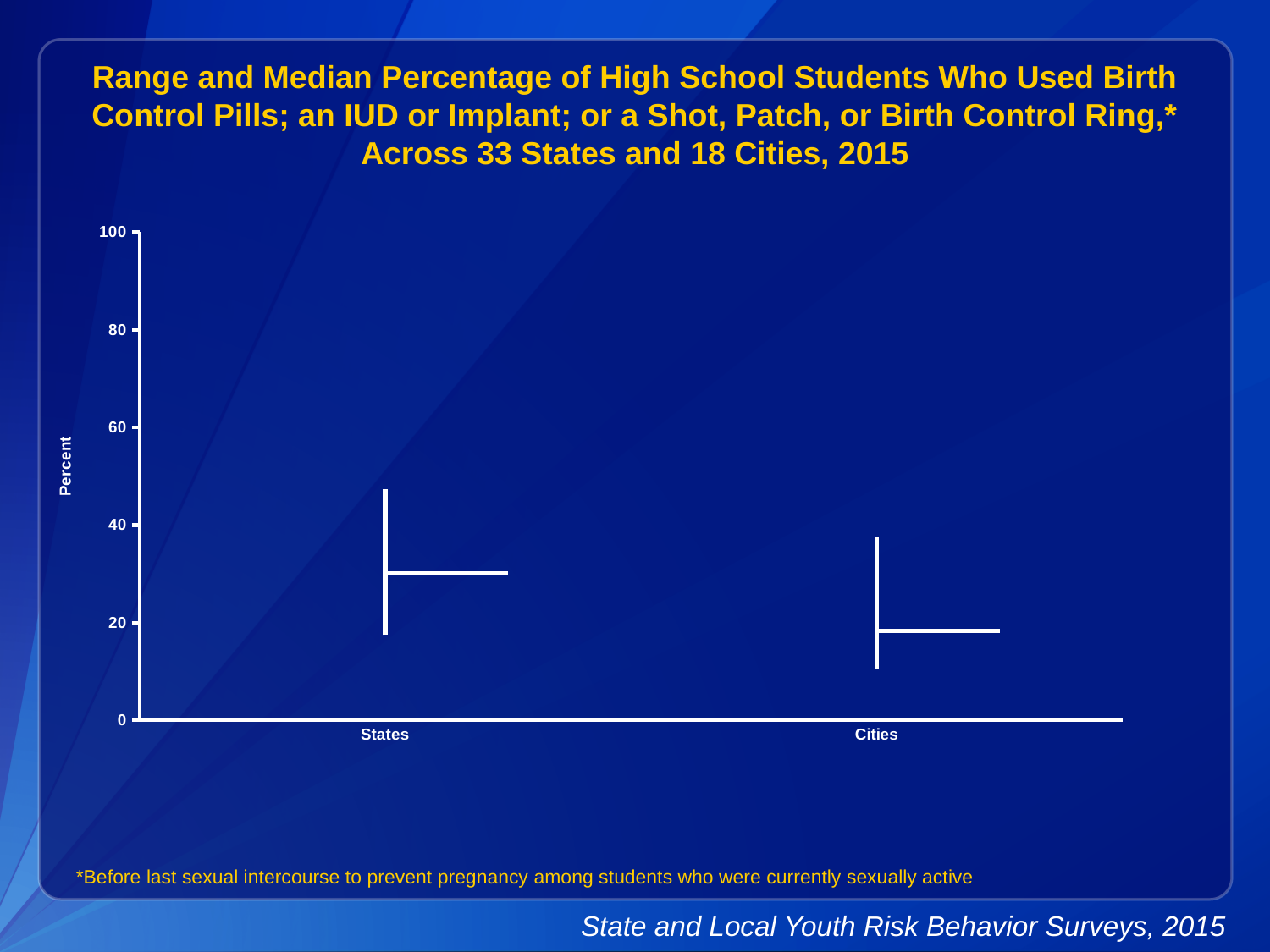
Is the bottom of the range for Cities greater or less than 20? less Is the top of the range for Cities greater or less than 60? less Which category has the higher median value, States or Cities? States Is the median value for Cities greater or less than 40? less What are the two categories shown on the x axis? States and Cities Which category has the higher top of its range, States or Cities? States Which category has the lower bottom of its range, States or Cities? Cities How many categories are shown on the x axis of the chart? 2 What is the label on the y axis of the chart? Percent